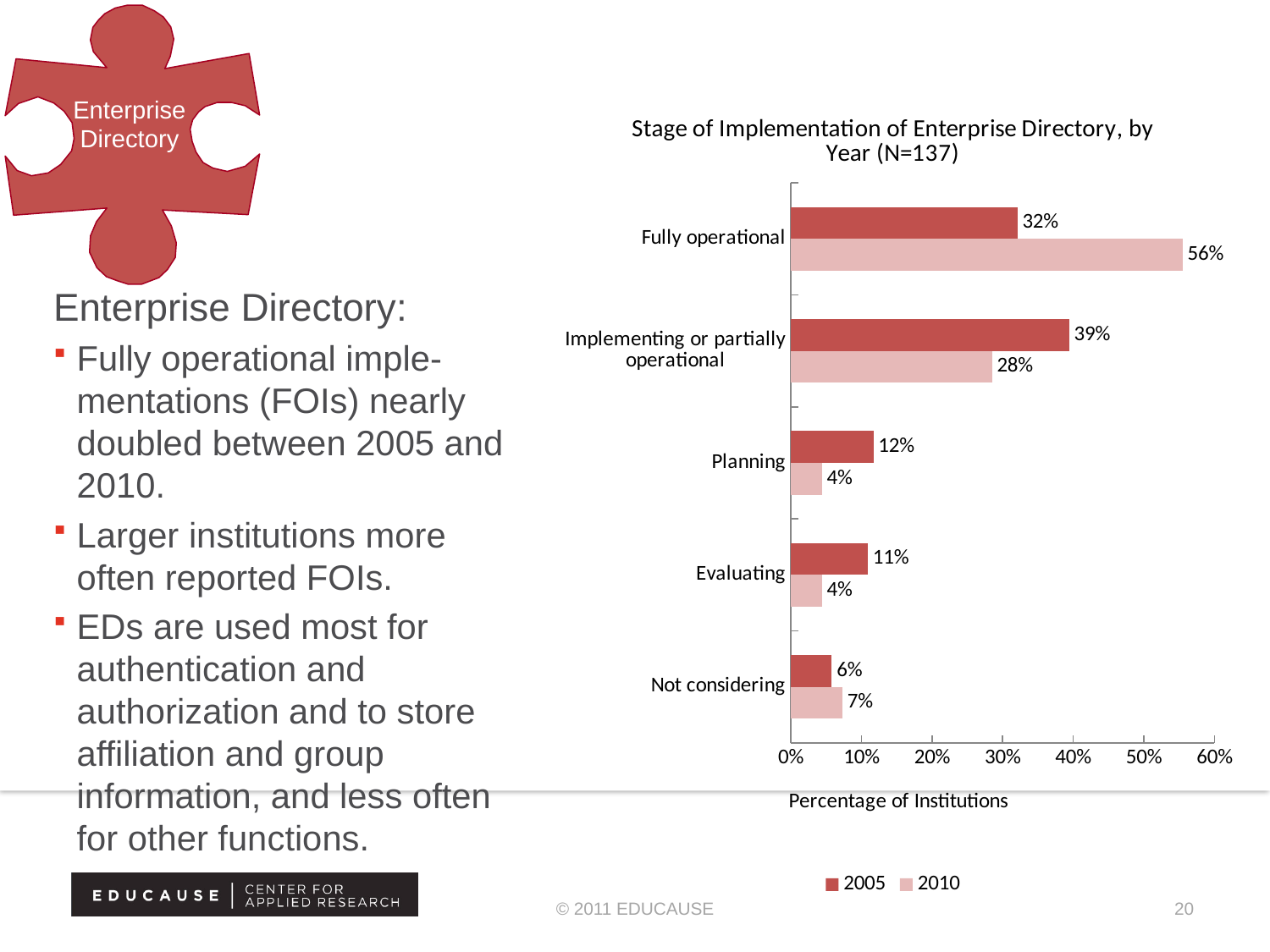
Which category has the highest value for the 2010 series? Fully operational How many categories are shown on the chart? 5 What percentage of institutions reported being fully operational in 2010? 56% How many series does the legend list? 2 Is the 2010 value for Fully operational greater or less than 50%? greater Which category has the lowest value for the 2005 series? Not considering What is the difference between the 2010 and 2005 values for Fully operational? 24% What is the label of the horizontal axis? Percentage of Institutions What is the 2005 value for Implementing or partially operational? 39% Which is larger for Implementing or partially operational: the 2005 value or the 2010 value? 2005 What kind of chart is shown on the slide? Bar chart What is the 2010 value for Planning? 4%